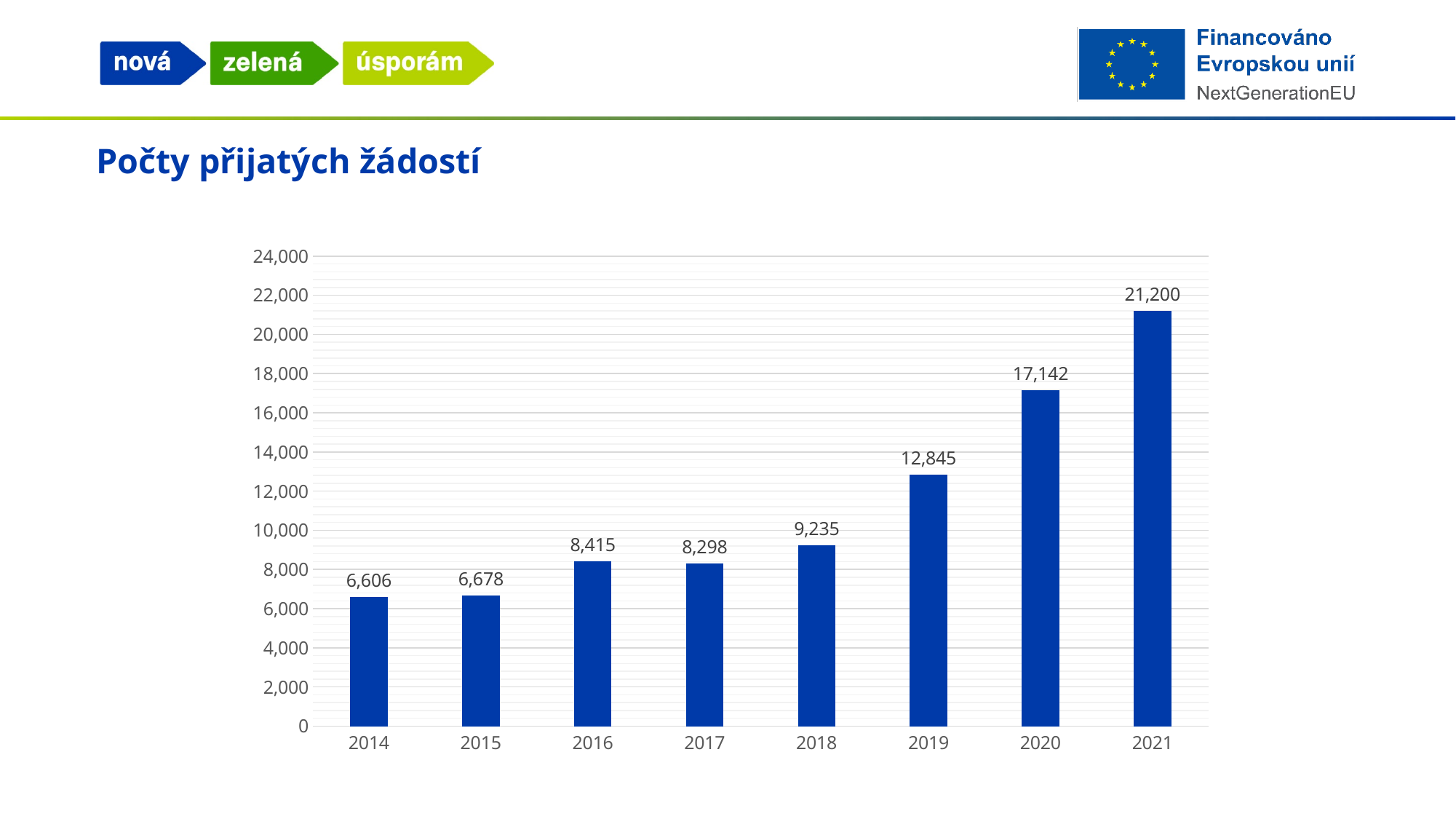
What is the title of the slide above the chart? Počty přijatých žádostí What kind of chart is shown on the slide? bar chart Which is larger, the value for 2018 or the value for 2017? 2018 Which year has the lowest value? 2014 What is the value for 2014? 6,606 What is the value for 2019? 12,845 Which year has the highest value? 2021 How many years are shown on the x axis? 8 Is the value for 2020 greater or less than 16,000? greater What is the value for 2021? 21,200 What is the difference between the values for 2016 and 2017? 117 What is the difference between the values for 2021 and 2020? 4,058